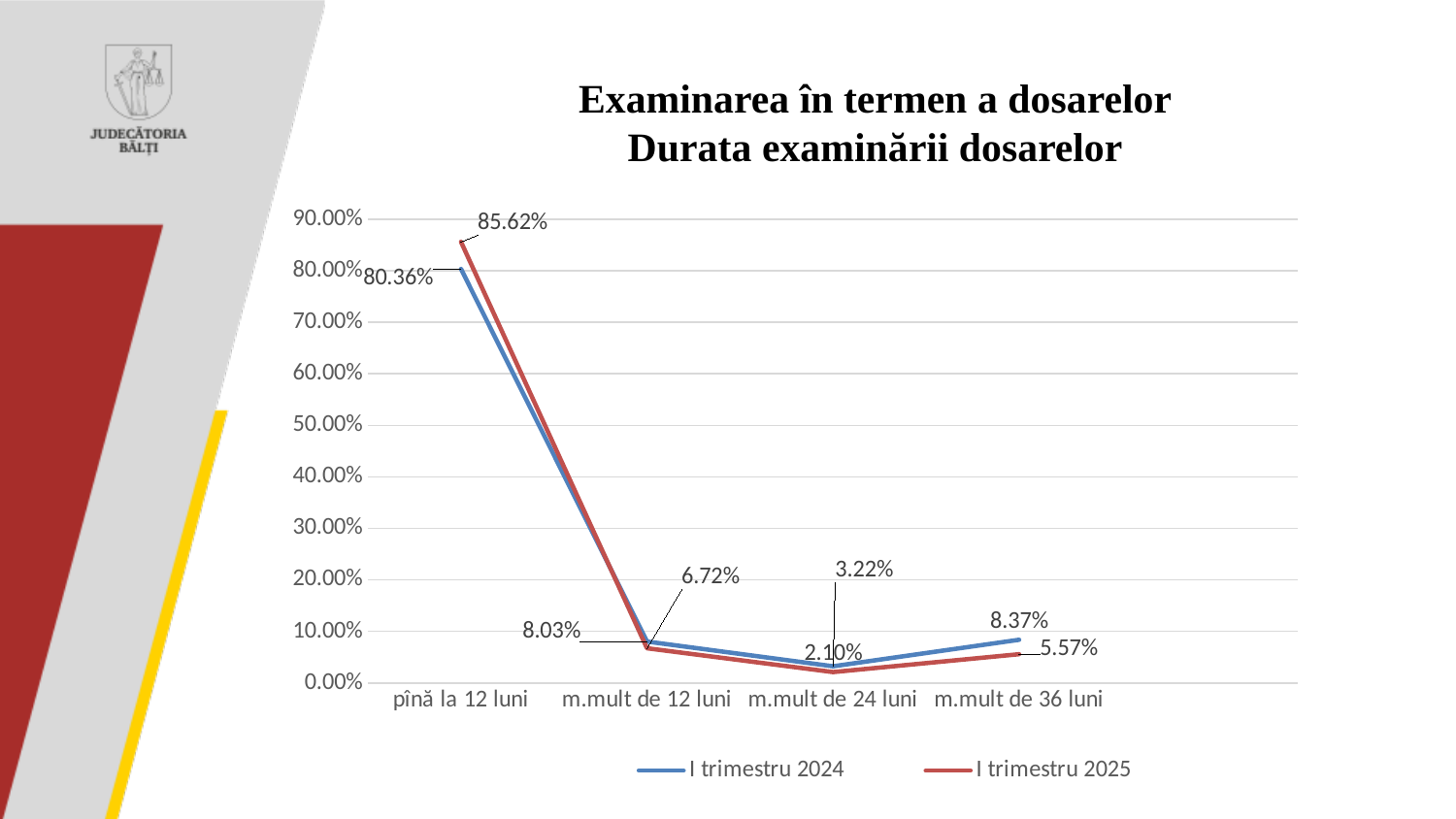
What is the value for 'm.mult de 24 luni' in the I trimestru 2025 series? 2.10% How many series does the legend list? 2 Which category has the highest value in the I trimestru 2025 series? pînă la 12 luni What is the title of the chart? Examinarea în termen a dosarelor Durata examinării dosarelor How many categories are shown on the x axis? 4 For 'm.mult de 36 luni', which series has the larger value, I trimestru 2024 or I trimestru 2025? I trimestru 2024 What is the value for 'pînă la 12 luni' in the I trimestru 2024 series? 80.36% What is the value for 'm.mult de 36 luni' in the I trimestru 2024 series? 8.37% Which category has the lowest value in the I trimestru 2024 series? m.mult de 24 luni What is the value for 'pînă la 12 luni' in the I trimestru 2025 series? 85.62% What type of chart is shown on the slide? line chart What is the difference between the I trimestru 2025 and I trimestru 2024 values for 'pînă la 12 luni'? 5.26%